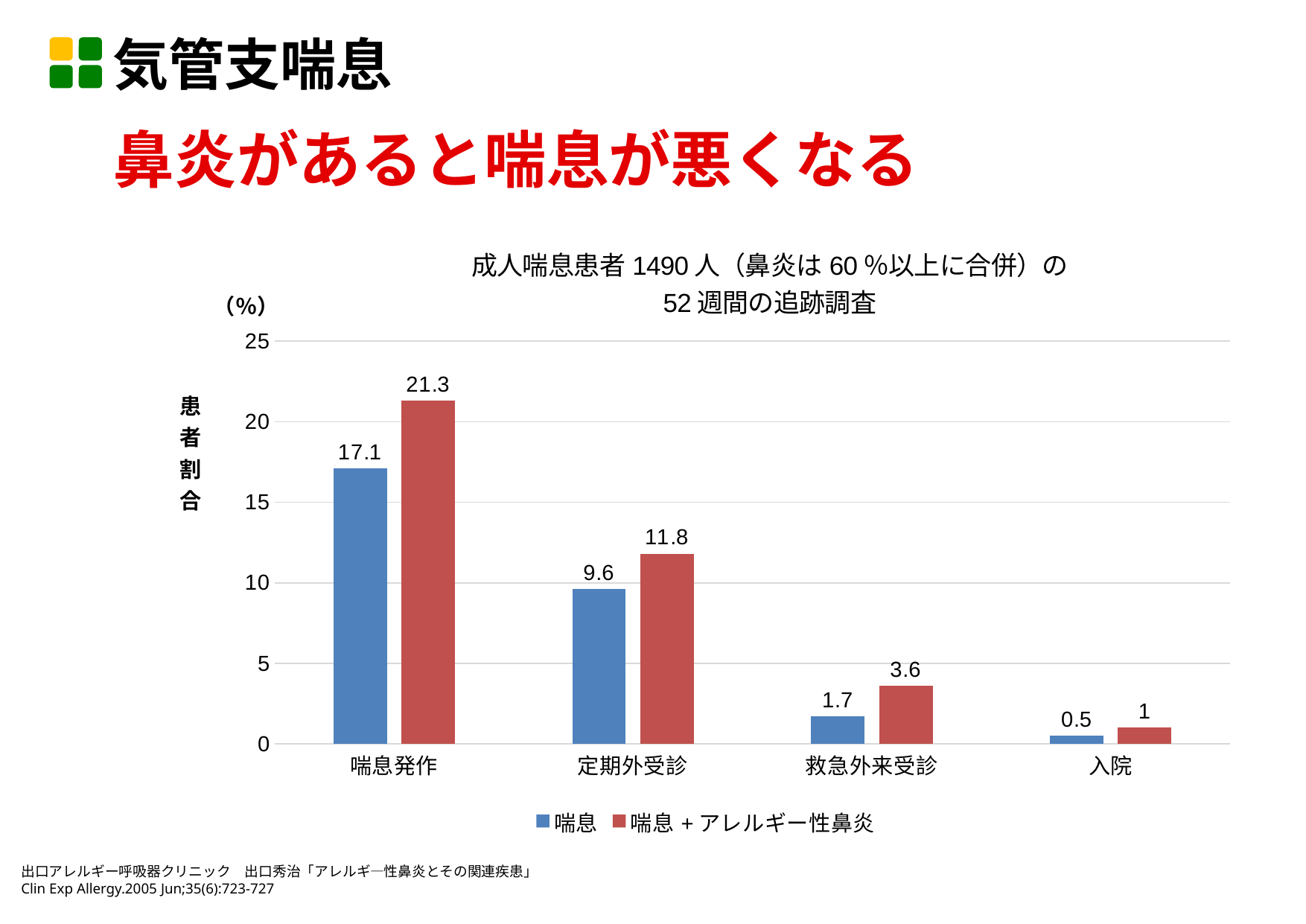
What kind of chart is shown on the slide? bar chart What is the difference between the 喘息 + アレルギー性鼻炎 and 喘息 values for 喘息発作? 4.2 How many series does the legend list? 2 What is the value for 喘息発作 in the 喘息 + アレルギー性鼻炎 series? 21.3 What is the difference between the 喘息 + アレルギー性鼻炎 and 喘息 values for 救急外来受診? 1.9 For 定期外受診, which series has the larger value, 喘息 or 喘息 + アレルギー性鼻炎? 喘息 + アレルギー性鼻炎 What is the value for 入院 in the 喘息 + アレルギー性鼻炎 series? 1 Which category has the lowest value in the 喘息 + アレルギー性鼻炎 series? 入院 What is the value for 定期外受診 in the 喘息 series? 9.6 Which category has the highest value in the 喘息 series? 喘息発作 What unit is shown on the y axis of the chart? % How many categories are shown on the x axis? 4